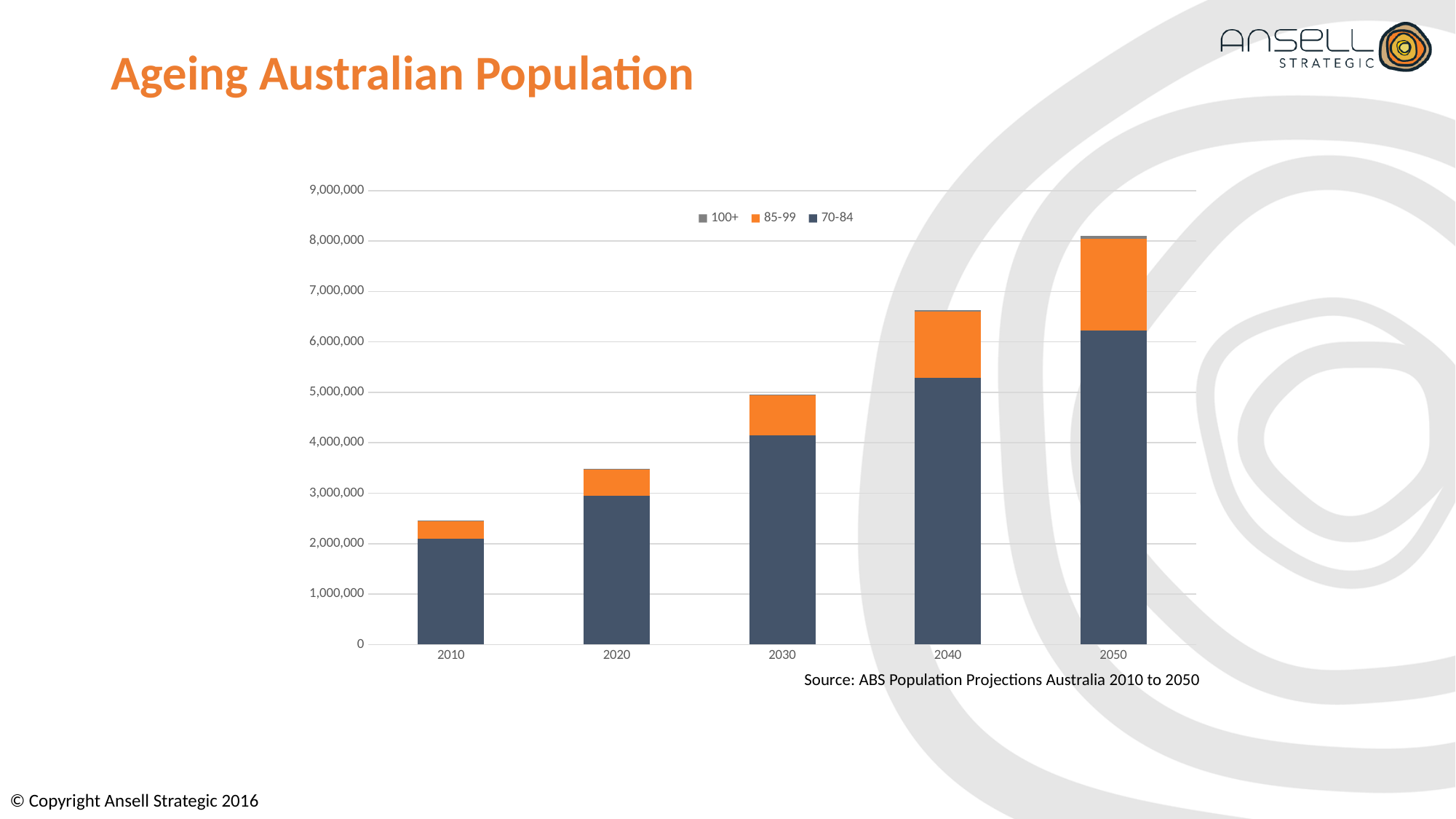
Which year has the shortest stacked bar? 2010 Is the 70-84 segment for 2030 greater or less than 4,000,000? greater How many years are shown on the x axis of the chart? 5 Which year has the tallest stacked bar? 2050 Is the total for 2040 greater or less than 6,000,000? greater How many series does the chart legend list? 3 Which series is shown in orange in the chart legend? 85-99 What kind of chart is shown on the slide? Stacked bar chart Do the stacked bar totals rise or fall from 2010 to 2050? Rise Which is larger, the 85-99 segment for 2050 or the 85-99 segment for 2010? 2050 Is the total for 2020 greater or less than 4,000,000? less